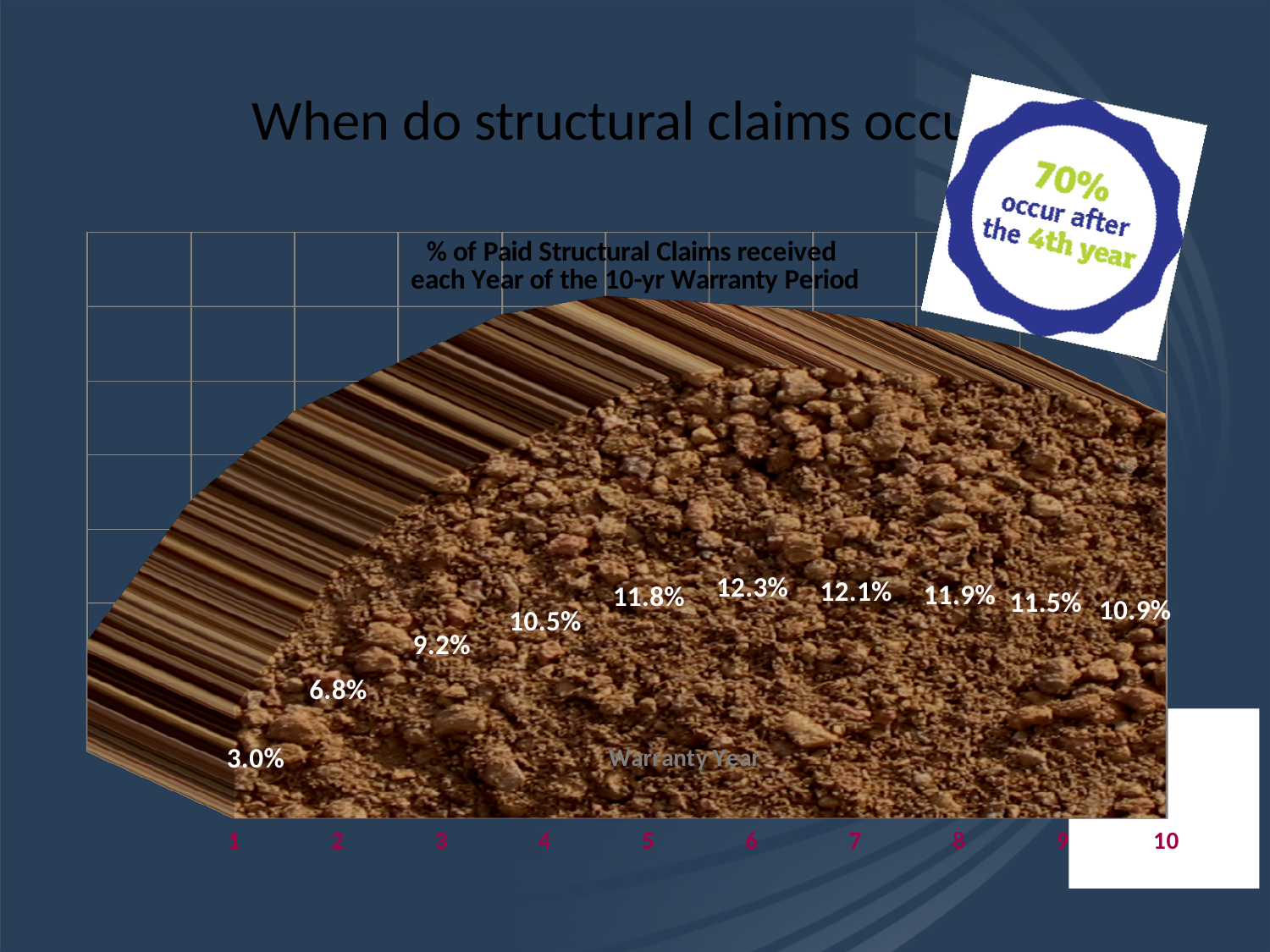
What percentage of paid structural claims is received in warranty year 10? 10.9% How many warranty years are plotted on the x axis? 10 What is the difference between the percentage of claims in warranty year 6 and warranty year 10? 1.4% What is the title of the chart? % of Paid Structural Claims received each Year of the 10-yr Warranty Period Do the percentages rise or fall from warranty year 1 to warranty year 6? Rise Which has a higher percentage of paid structural claims, warranty year 3 or warranty year 9? Warranty year 9 What percentage of paid structural claims is received in warranty year 4? 10.5% What percentage of paid structural claims is received in warranty year 1? 3.0% What is the label of the x axis? Warranty Year Which warranty year has the lowest percentage of paid structural claims? 1 Which warranty year has the highest percentage of paid structural claims? 6 What is the difference between the percentage of claims in warranty year 2 and warranty year 1? 3.8%